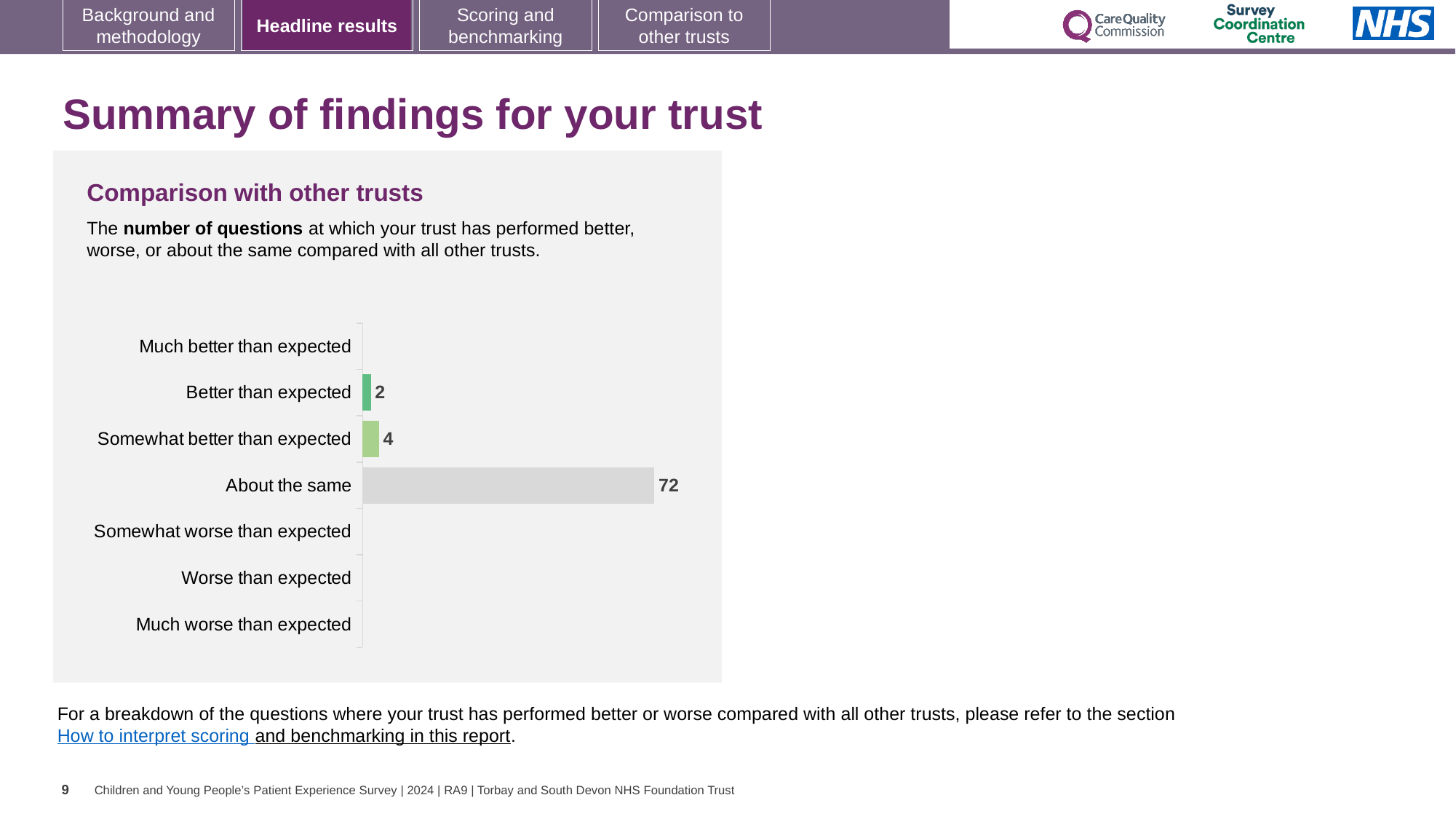
What is the value for 'Better than expected'? 2 What is the difference between 'Somewhat better than expected' and 'Better than expected'? 2 How many categories are listed on the chart's axis? 7 What is the value for 'Somewhat better than expected'? 4 What colour is the 'About the same' bar? Grey What is the difference between the 'About the same' value and the 'Somewhat better than expected' value? 68 What is the total number of questions across the 'Better than expected', 'Somewhat better than expected' and 'About the same' categories? 78 What kind of chart is shown on the slide? Bar chart What is the title of the chart section? Comparison with other trusts Which is larger: 'Better than expected' or 'Somewhat better than expected'? Somewhat better than expected How many questions are in the 'About the same' category? 72 Which category has the highest number of questions? About the same